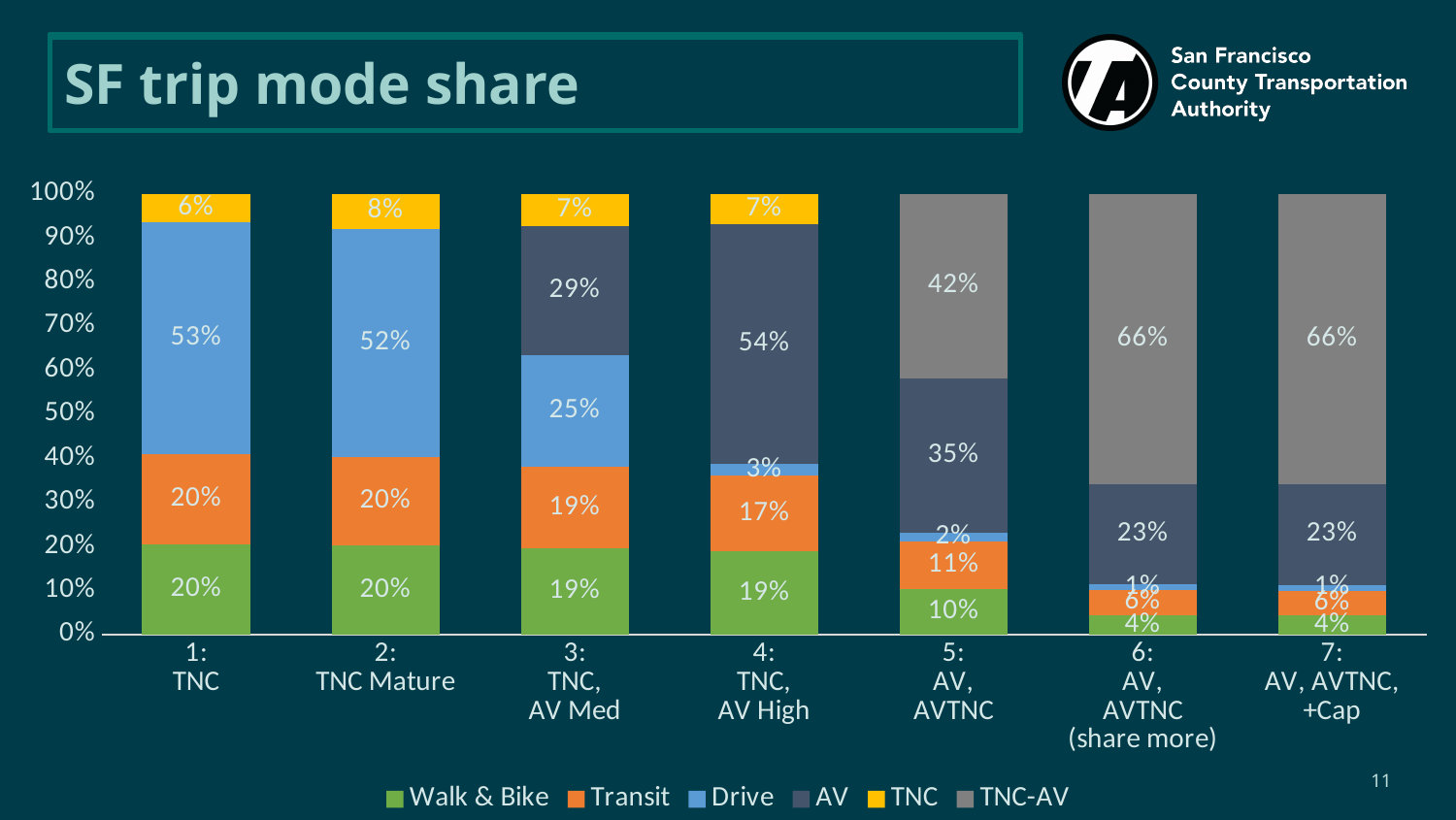
Which scenario has the lowest Transit share? 6: AV, AVTNC (share more) and 7: AV, AVTNC, +Cap (tied at 6%) What is the difference between the AV share in scenario 4: TNC, AV High and scenario 3: TNC, AV Med? 25% How many scenarios are shown on the x axis? 7 What is the Drive share for scenario 1: TNC? 53% What is the Walk & Bike share for scenario 6: AV, AVTNC (share more)? 4% Which scenario has the highest Drive share? 1: TNC How many series does the legend list? 6 What is the AV share for scenario 4: TNC, AV High? 54% Which is larger, the Drive share in scenario 3: TNC, AV Med or the AV share in scenario 3: TNC, AV Med? AV What is the TNC share for scenario 2: TNC Mature? 8% What is the TNC-AV share for scenario 5: AV, AVTNC? 42% What kind of chart is shown on the slide? Stacked bar chart